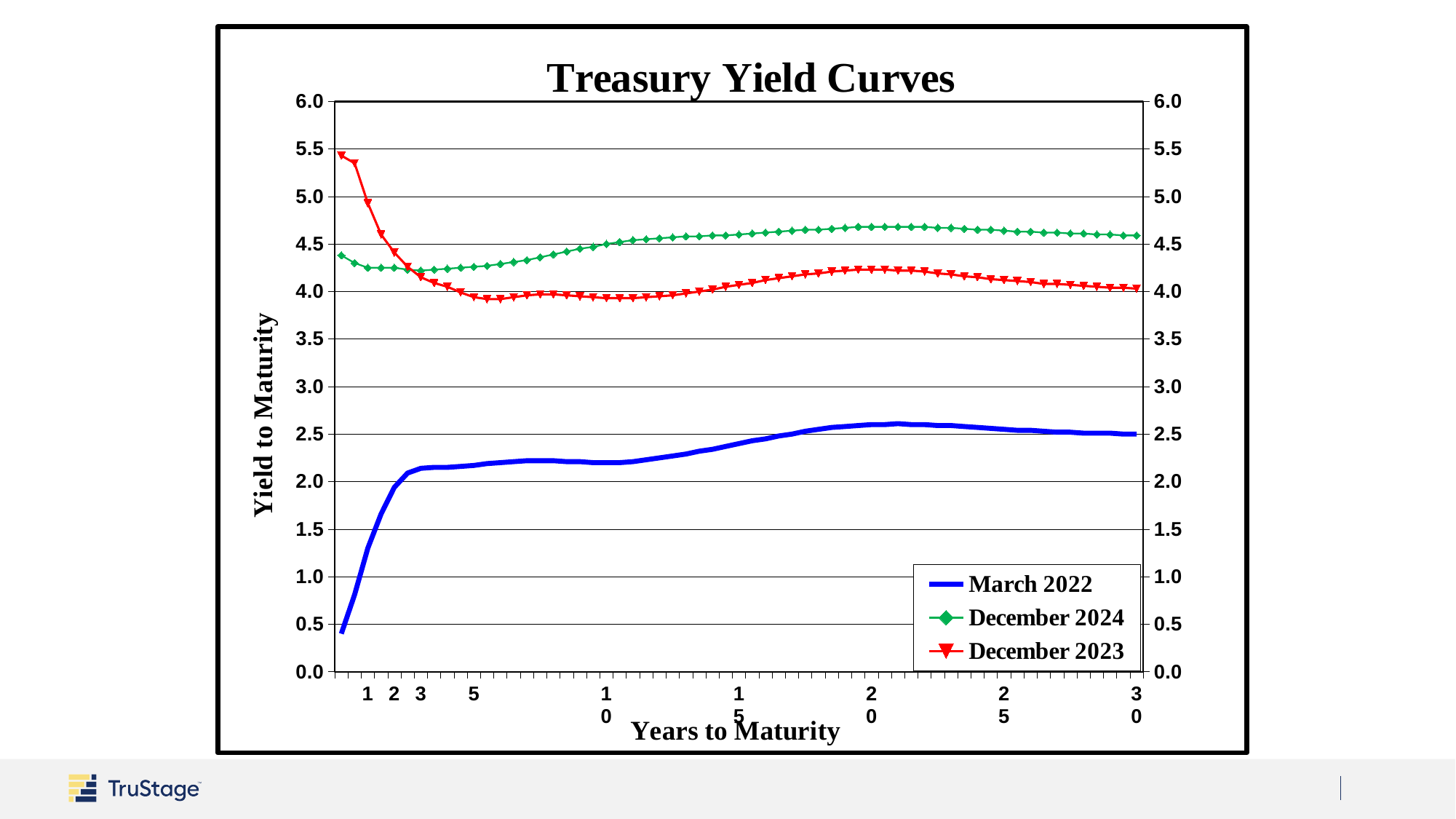
What kind of chart is shown on the slide? line chart At 30 years to maturity, which series has the higher yield: December 2024 or December 2023? December 2024 What is the title of the chart? Treasury Yield Curves Is the December 2024 yield at 30 years to maturity greater or less than 4.5? greater What is the label of the vertical axis? Yield to Maturity Does the December 2023 yield rise or fall between 1 and 5 years to maturity? fall Which series has the lowest yields across all maturities? March 2022 Is the March 2022 yield at 10 years to maturity greater or less than 2.0? greater How many series does the legend list? 3 Is the December 2023 yield at the shortest maturity greater or less than 5.0? greater At 1 year to maturity, which series has the higher yield: December 2023 or December 2024? December 2023